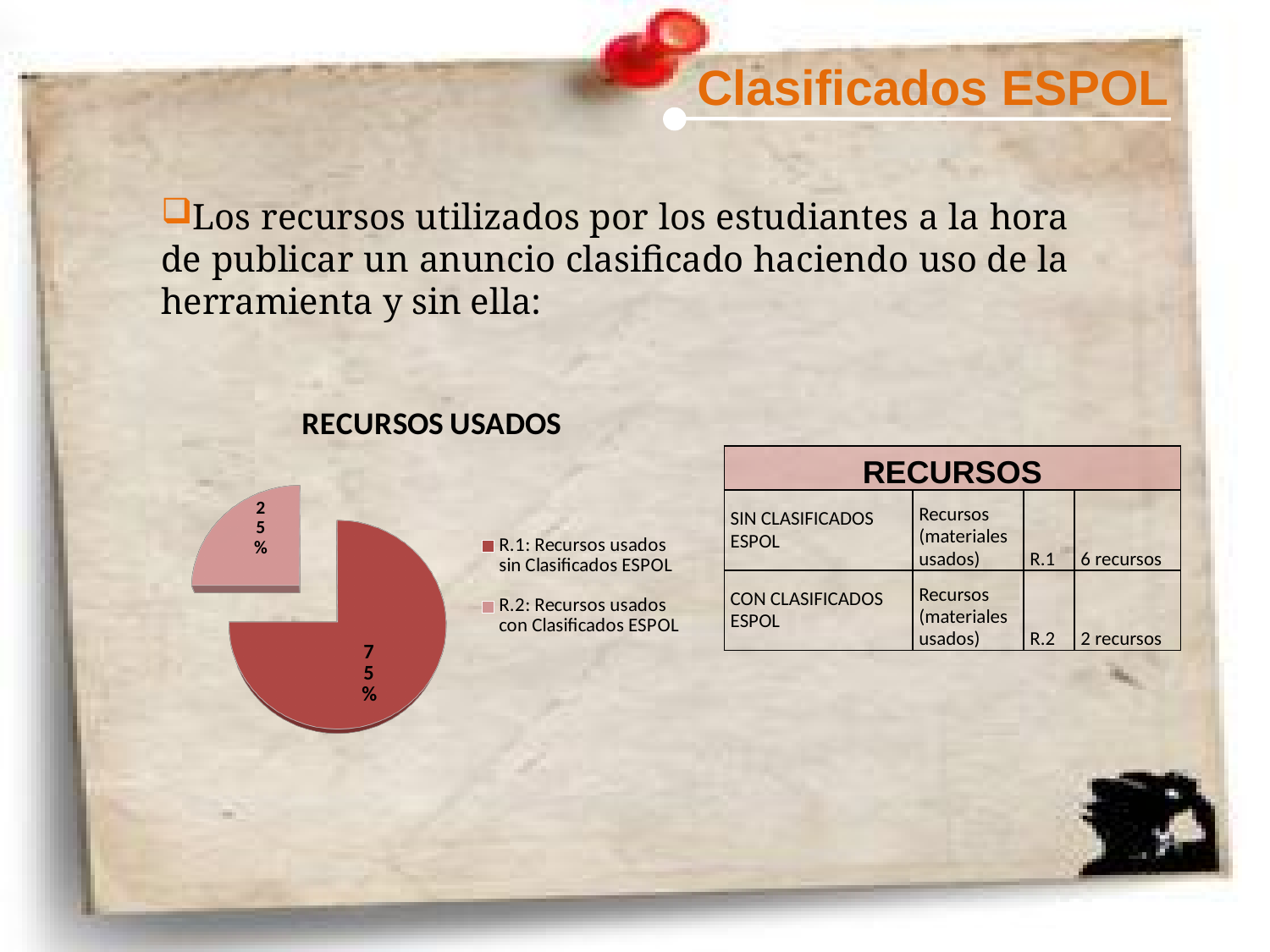
Which is larger in the pie chart: the R.1 slice or the R.2 slice? R.1 Is the share for "R.2: Recursos usados con Clasificados ESPOL" greater or less than 50%? less What share of the pie does "R.2: Recursos usados con Clasificados ESPOL" represent? 25% What kind of chart is shown under the title "RECURSOS USADOS"? pie chart What is the title of the pie chart? RECURSOS USADOS What is the difference in percentage points between the R.1 slice and the R.2 slice? 50 percentage points What share of the pie does "R.1: Recursos usados sin Clasificados ESPOL" represent? 75% Which slice of the pie chart is the smallest? R.2: Recursos usados con Clasificados ESPOL Which slice of the pie chart is the largest? R.1: Recursos usados sin Clasificados ESPOL Which slice of the pie chart is shown in the lighter pink colour? R.2: Recursos usados con Clasificados ESPOL How many entries does the legend of the pie chart list? 2 How many slices does the pie chart have? 2